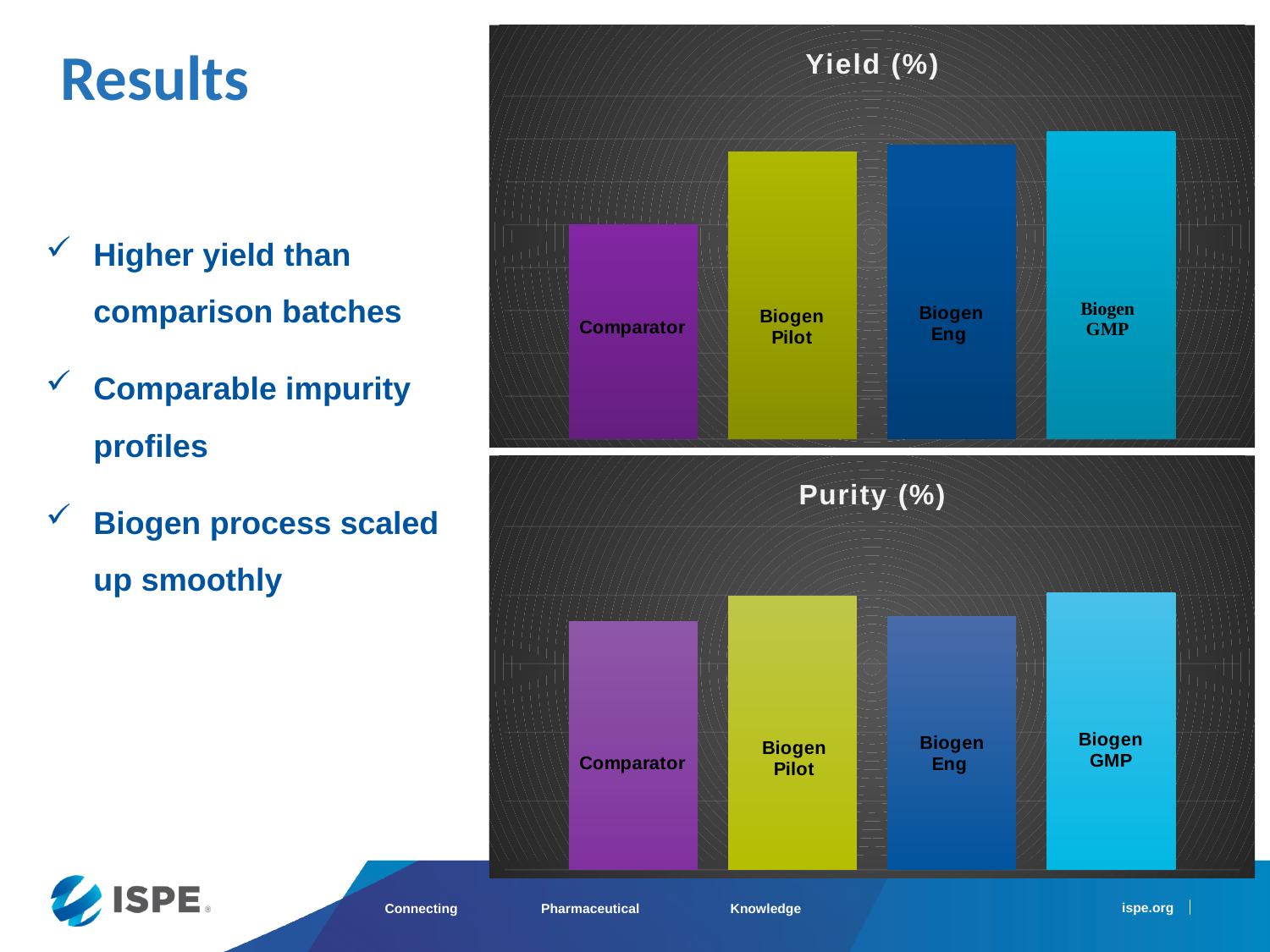
What is the title of the top chart on the slide? Yield (%) In the Yield (%) chart, which category has the highest value? Biogen GMP In the Yield (%) chart, do the values rise or fall from left to right? rise In the Yield (%) chart, which is larger: Comparator or Biogen Pilot? Biogen Pilot How many categories are shown in the Yield (%) chart? 4 What kind of chart is the Yield (%) chart? bar chart In the Yield (%) chart, which category has the lowest value? Comparator How many categories are shown in the Purity (%) chart? 4 In the Purity (%) chart, which is larger: Biogen Eng or Biogen Pilot? Biogen Pilot What kind of chart is the Purity (%) chart? bar chart How many charts are shown on the slide? 2 In the Purity (%) chart, which is larger: Comparator or Biogen GMP? Biogen GMP